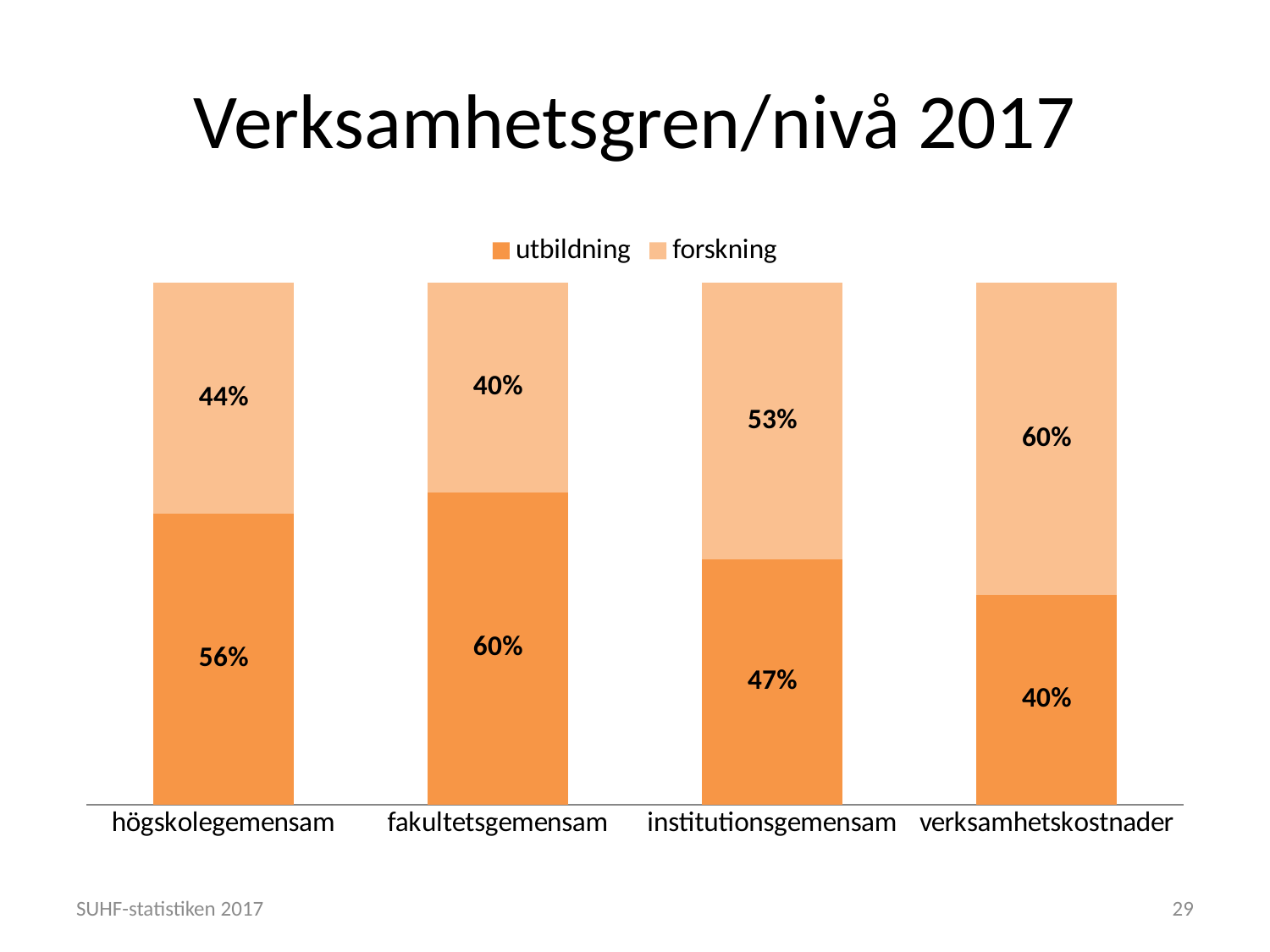
What is the utbildning share for högskolegemensam? 56% What kind of chart is shown? stacked bar chart What is the title of the chart? Verksamhetsgren/nivå 2017 How many categories are shown on the x axis? 4 How many series does the legend list? 2 What is the difference between the utbildning shares of högskolegemensam and verksamhetskostnader? 16 percentage points Which category has the highest utbildning share? fakultetsgemensam What is the forskning share for institutionsgemensam? 53% Which is larger for institutionsgemensam, the utbildning share or the forskning share? forskning What is the utbildning share for verksamhetskostnader? 40% What is the forskning share for fakultetsgemensam? 40% Which category has the lowest forskning share? fakultetsgemensam